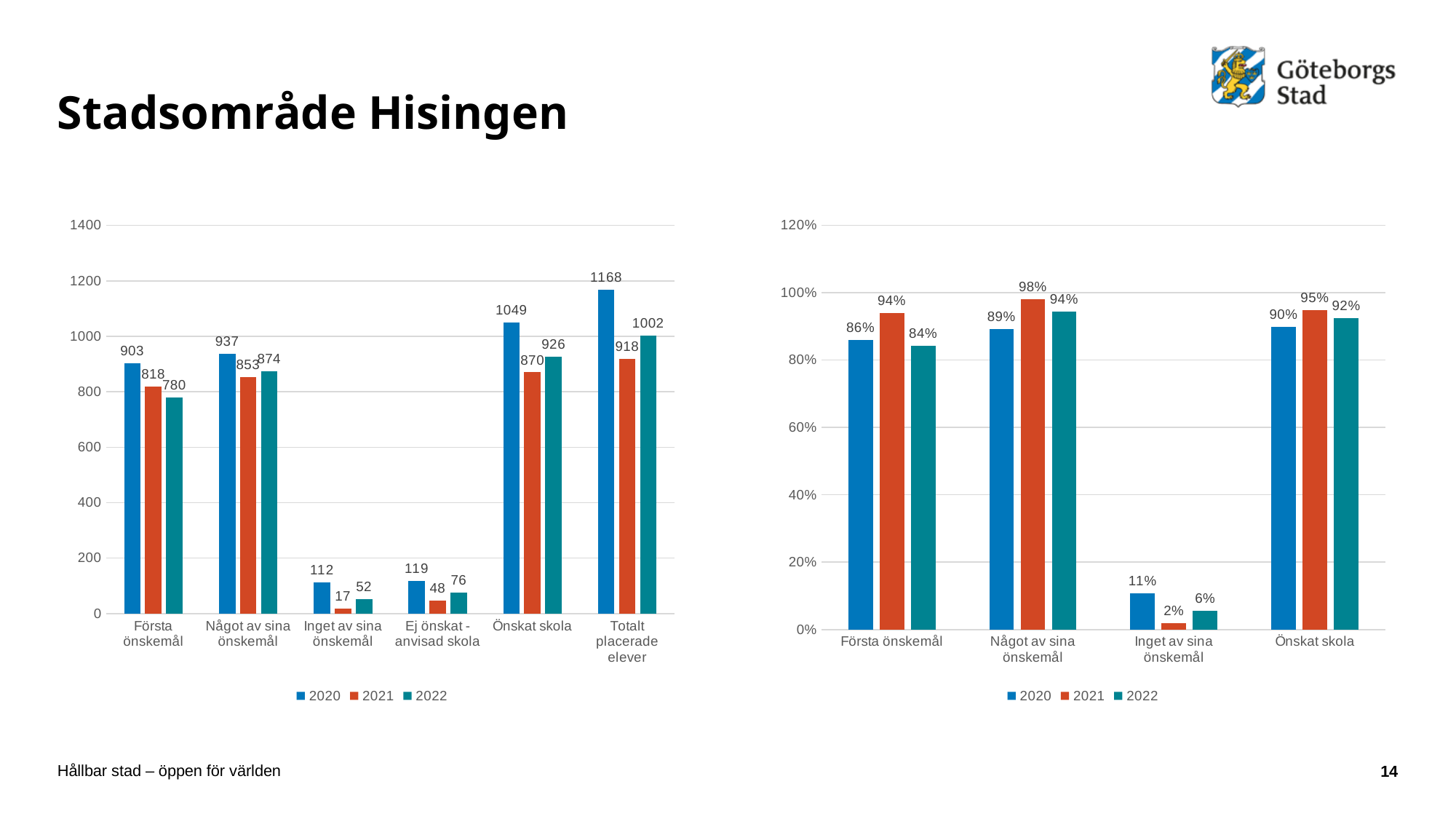
How many series does the legend of the right chart list? 3 In the left chart, what is the value for 2020 in the 'Första önskemål' category? 903 In the right chart, is the 2021 value for 'Önskat skola' larger or smaller than the 2020 value? larger In the left chart, what is the value for 2021 in the 'Inget av sina önskemål' category? 17 In the left chart, what is the value for 2022 in the 'Totalt placerade elever' category? 1002 In the right chart, which year has the lowest value in the 'Första önskemål' category? 2022 In the left chart, what is the difference between the 2020 and 2021 values for 'Önskat skola'? 179 In the left chart, how many categories are shown on the x axis? 6 In the right chart, what is the value for 2021 in the 'Något av sina önskemål' category? 98% What kind of chart is the left chart? bar chart In the right chart, what is the value for 2022 in the 'Inget av sina önskemål' category? 6% In the left chart, which year has the highest value in the 'Totalt placerade elever' category? 2020